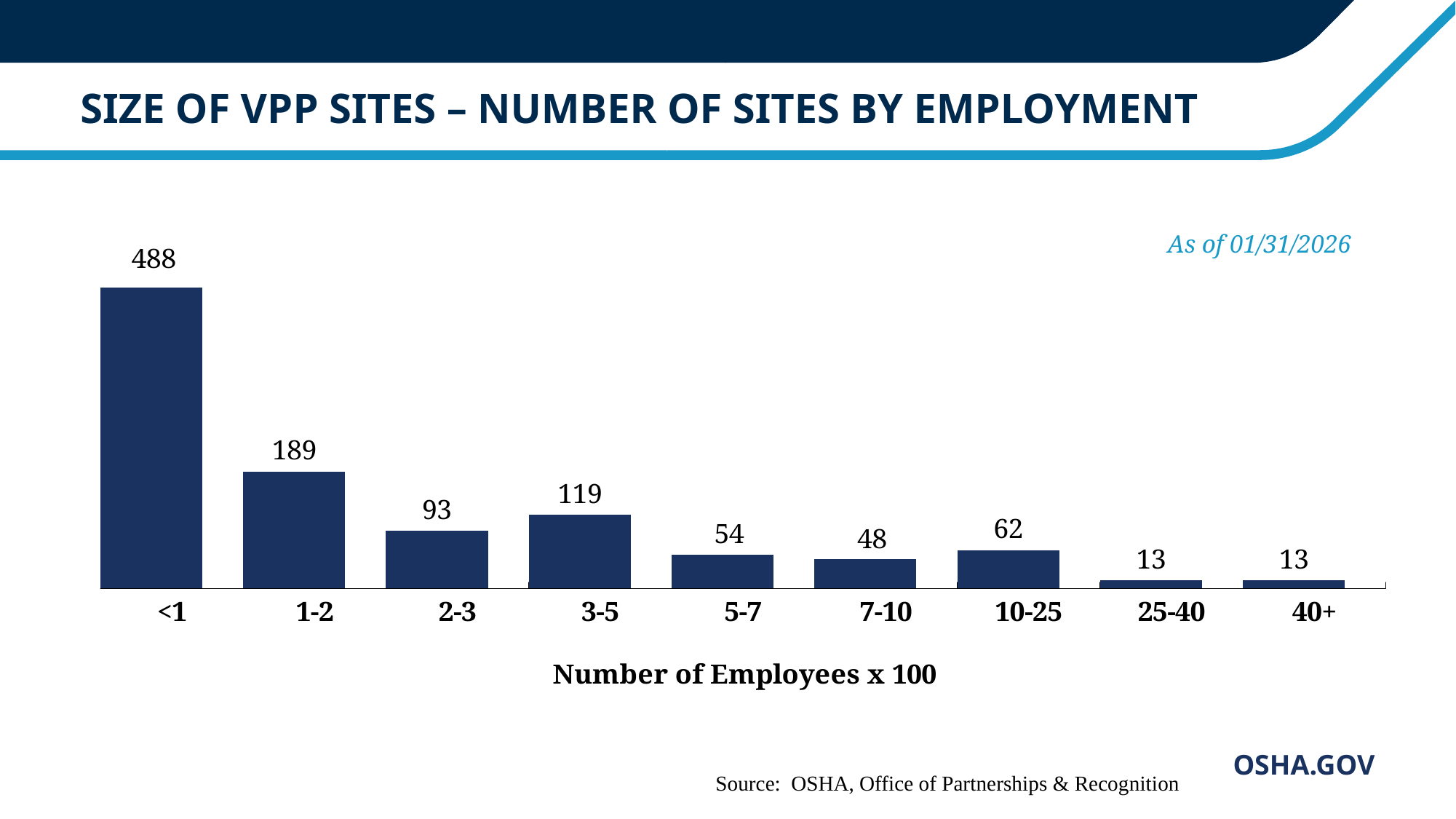
How many employment categories are shown on the x axis? 9 What is the difference between the number of sites in the '<1' category and the '1-2' category? 299 As of what date is the chart data reported? 01/31/2026 How many VPP sites have fewer than 100 employees (the '<1' category)? 488 Which employment category has the highest number of sites? <1 What is the difference between the number of sites in the '3-5' category and the '2-3' category? 26 Which has more sites, the '5-7' category or the '7-10' category? 5-7 What is the label of the x axis? Number of Employees x 100 What is the number of sites in the '10-25' employment category? 62 What is the number of sites in the '3-5' employment category? 119 What kind of chart is shown on the slide? Bar chart Which employment category has the lowest number of sites? 25-40 and 40+ (both 13)